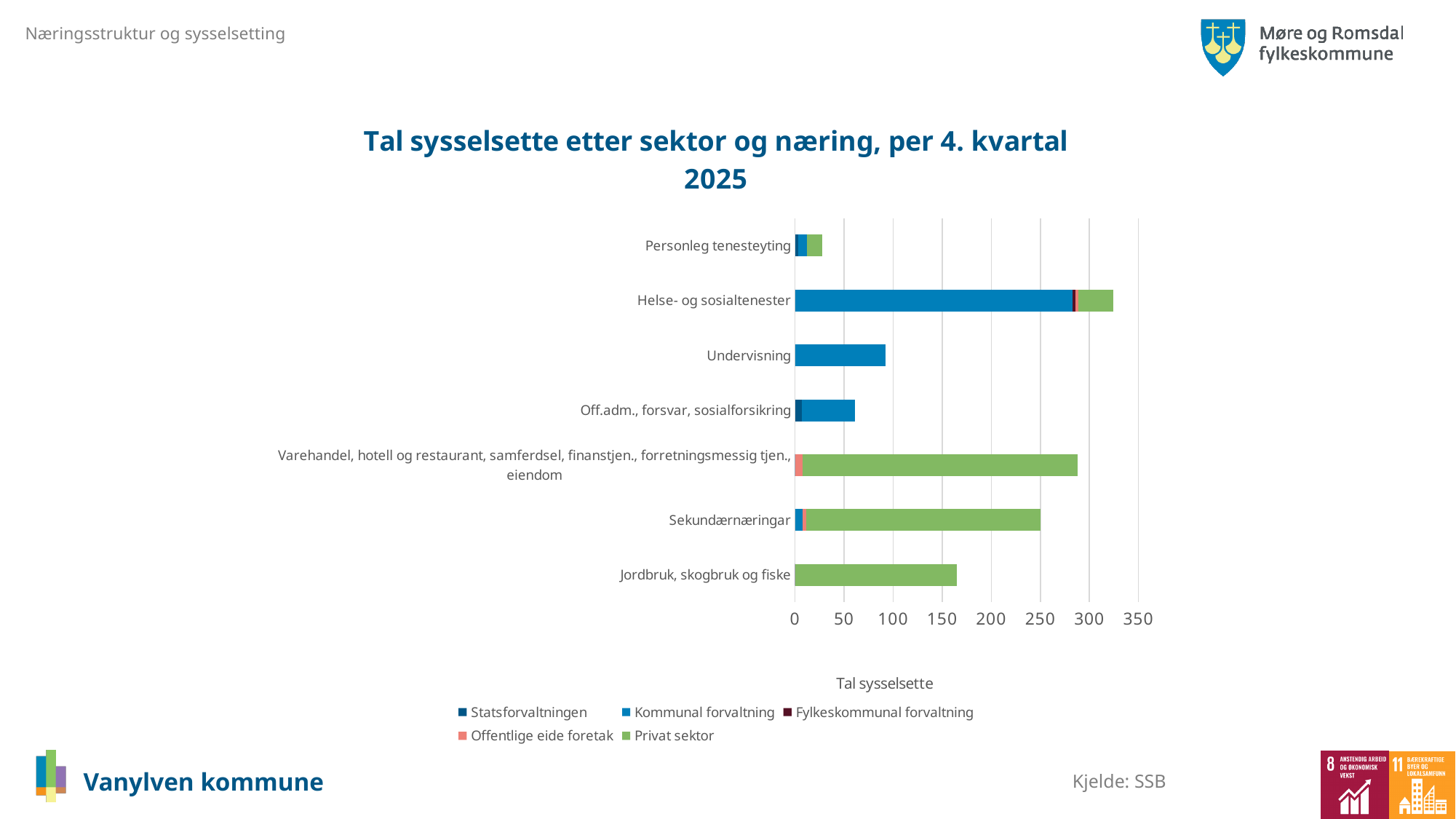
Is the value for Undervisning greater or less than 100? less What kind of chart is shown on the slide? bar chart Is the total value for Personleg tenesteyting greater or less than 50? less Is the total value for Helse- og sosialtenester greater or less than 300? greater How many series does the legend list? 5 Which has the larger total bar: Helse- og sosialtenester or Varehandel, hotell og restaurant, samferdsel, finanstjen., forretningsmessig tjen., eiendom? Helse- og sosialtenester Which series is shown in green in the legend? Privat sektor Which category has the shortest total bar? Personleg tenesteyting How many categories (næringar) are plotted on the chart? 7 What is the label on the horizontal axis of the chart? Tal sysselsette Which category has the longest total bar? Helse- og sosialtenester